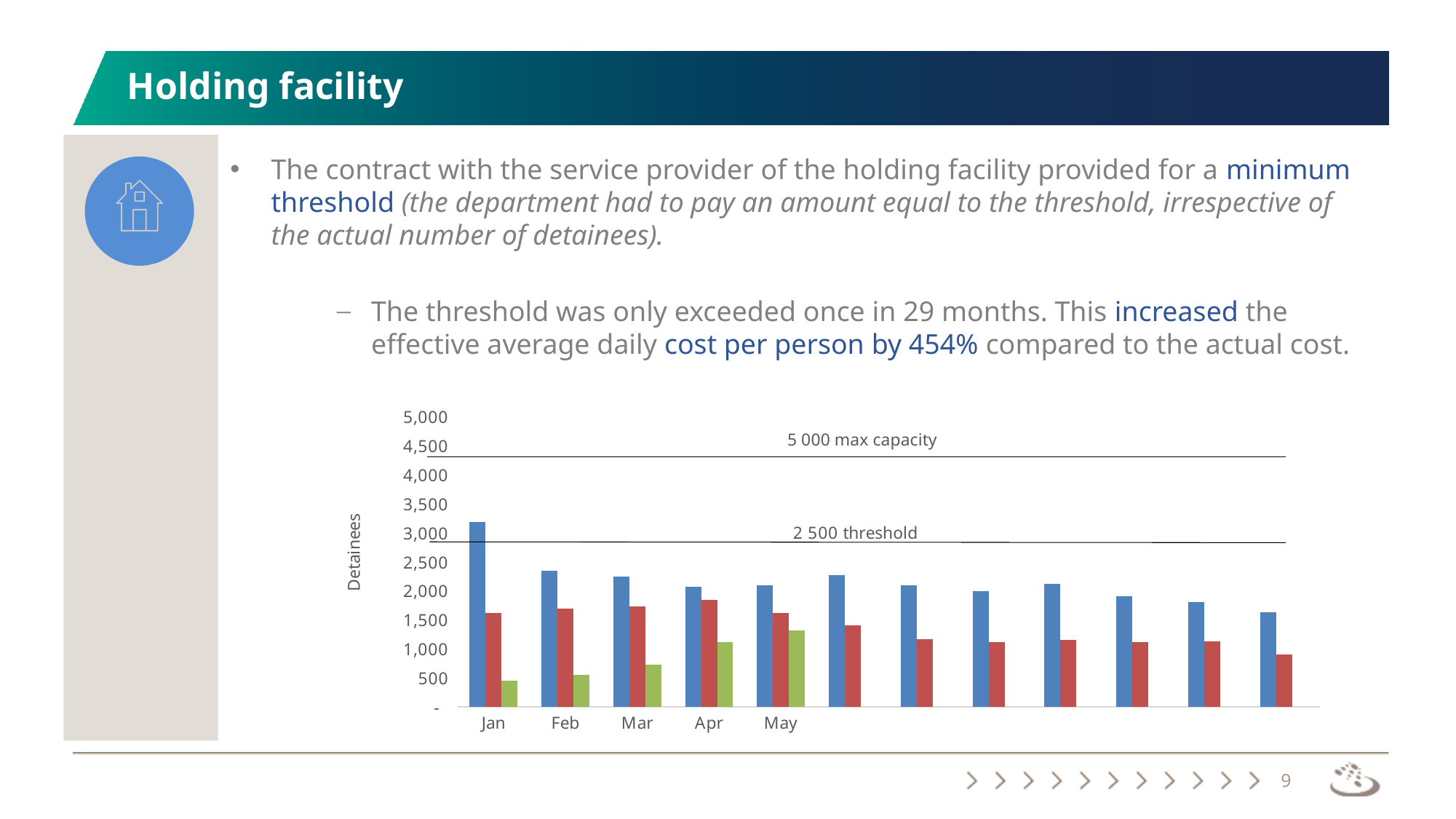
How many groups of bars are plotted on the chart? 12 Is the value of the red bar for Apr greater or less than 1,500? greater What is the label on the upper horizontal line across the chart? 5 000 max capacity What is the title of the vertical axis? Detainees Do the green bars rise or fall from Jan to May? rise Is the value of the green bar for May greater or less than 1,000? greater In Jan, which is larger, the blue bar or the red bar? blue bar Is the value of the blue bar for Jan greater or less than 3,000? greater Which labelled month has the lowest green bar? Jan Which labelled month has the highest blue bar? Jan What kind of chart is shown on the slide? bar chart